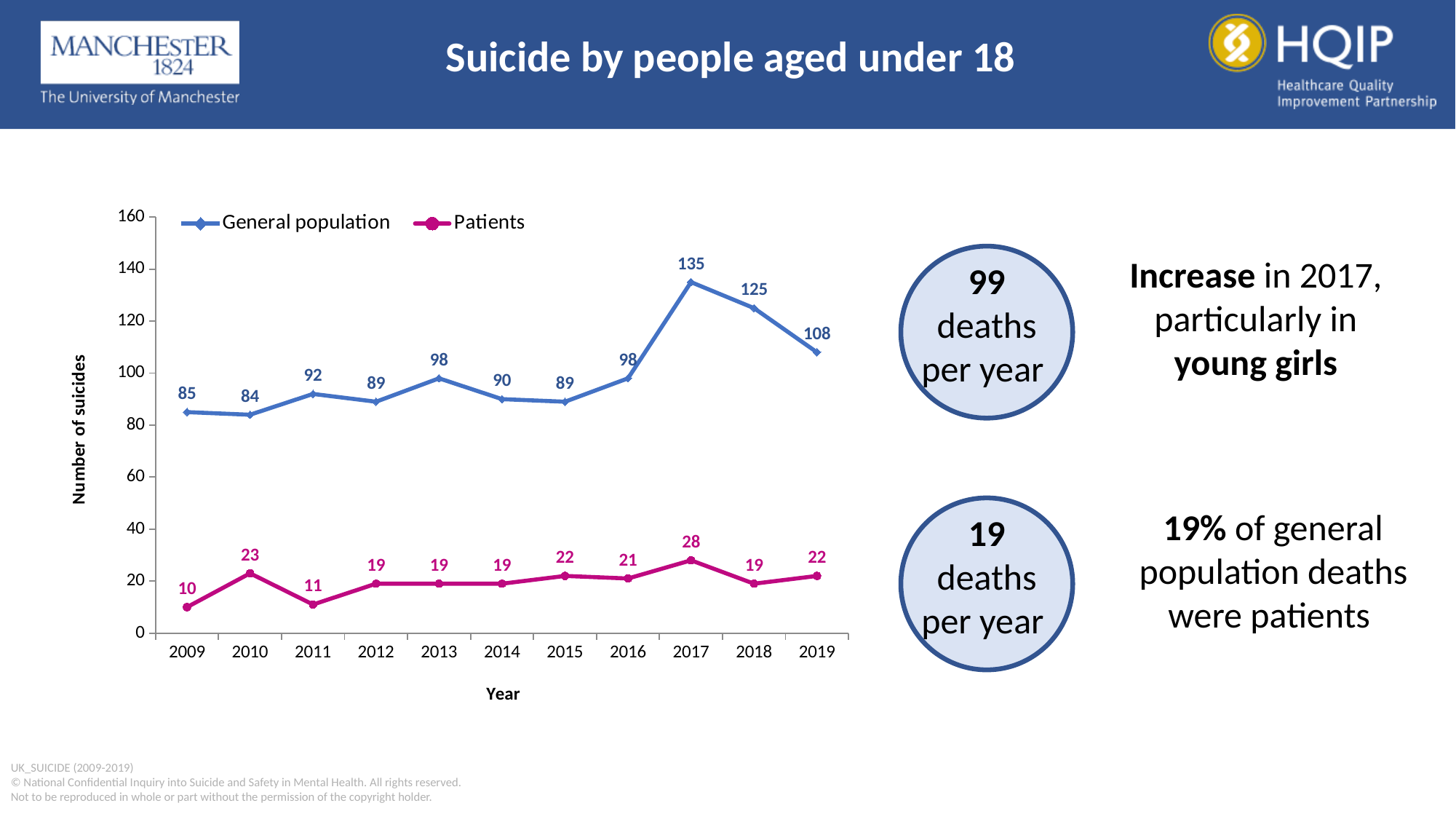
How many years are plotted on the x axis? 11 What is the value for General population in 2017? 135 Which is larger for Patients: 2010 or 2011? 2010 In which year is the Patients series highest? 2017 In which year is the General population series lowest? 2010 What is the difference between General population and Patients in 2017? 107 How many series does the legend list? 2 What is the value for Patients in 2011? 11 What is the value for General population in 2019? 108 Does the General population series rise or fall from 2017 to 2019? Fall What is the label of the y axis? Number of suicides What kind of chart is shown? Line chart